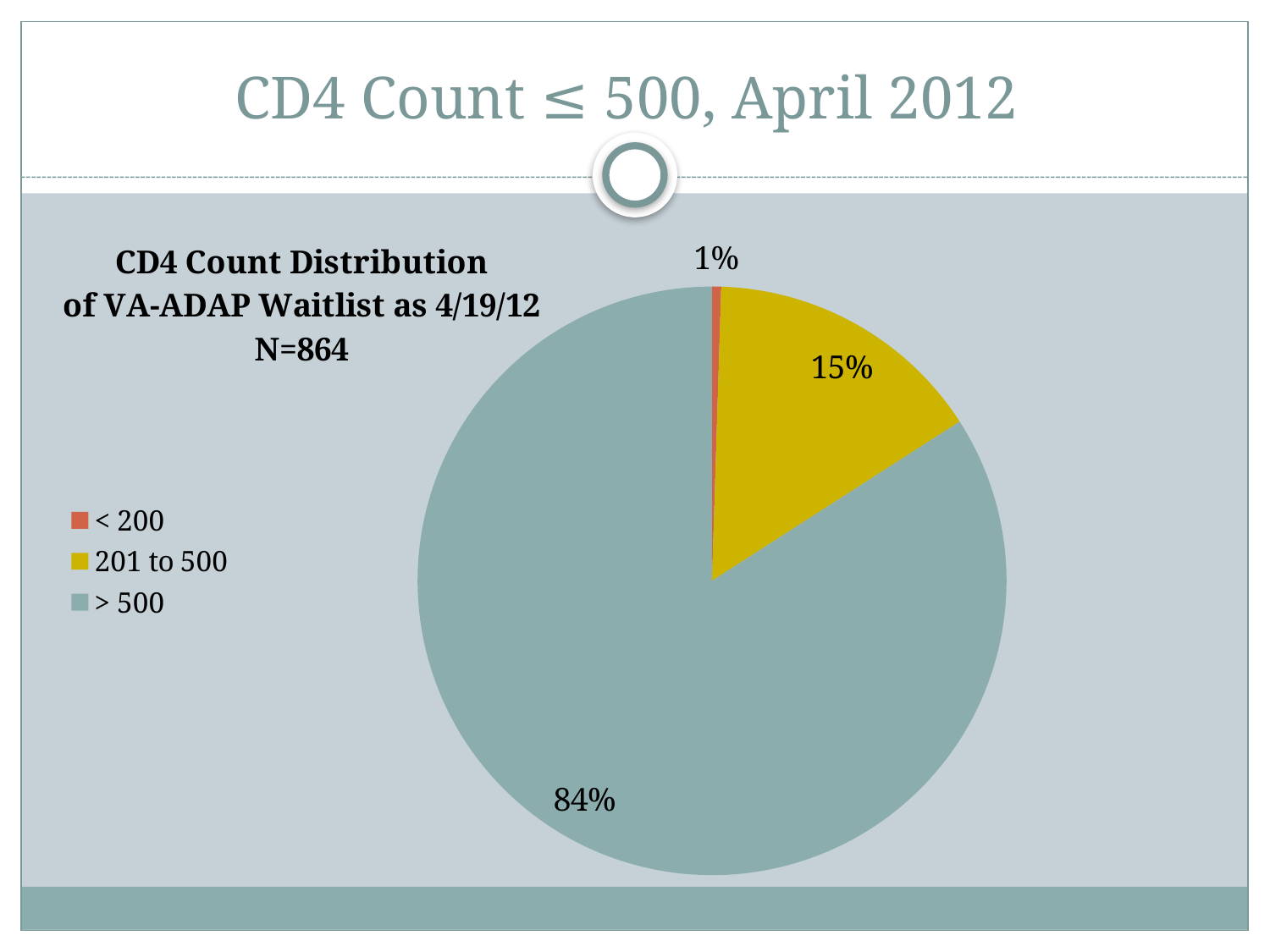
Which category has the largest slice of the pie? > 500 What is the N value stated in the chart's title text? N=864 What share of the pie does the "> 500" category have? 84% How many categories does the pie chart show? 3 What is the difference in percentage points between the "201 to 500" and "< 200" slices? 14 What share of the pie does the "201 to 500" category have? 15% What kind of chart is shown on the slide? pie chart Which category has the smallest slice of the pie? < 200 What share of the pie does the "< 200" category have? 1% Which slice is larger, "201 to 500" or "< 200"? 201 to 500 What is the difference in percentage points between the "> 500" and "201 to 500" slices? 69 What colour is the "201 to 500" slice in the pie chart? yellow